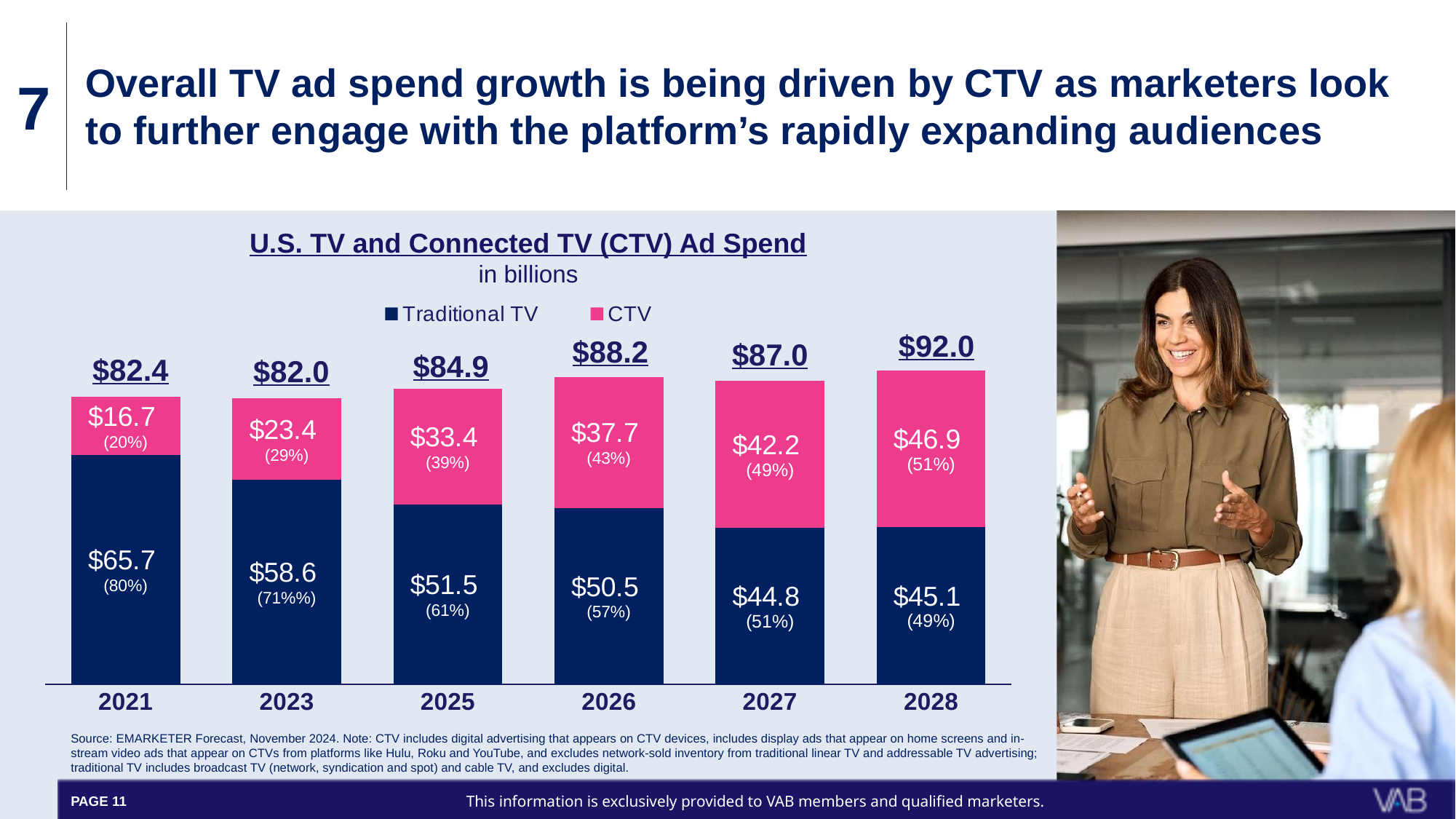
Which year has the highest CTV ad spend? 2028 Which year has the lowest Traditional TV ad spend? 2027 How many series does the legend list? 2 Which is larger in 2027, the Traditional TV value or the CTV value? Traditional TV What is the difference between the CTV ad spend in 2028 and in 2021? $30.2 How many years are shown on the x axis? 6 What is the total TV ad spend shown for 2028? $92.0 What is the Traditional TV ad spend value for 2021? $65.7 What kind of chart is shown? Stacked bar chart What percentage share of total TV ad spend does CTV have in 2026? 43% Does the CTV ad spend rise or fall from 2021 to 2028? Rise What is the CTV ad spend value for 2025? $33.4